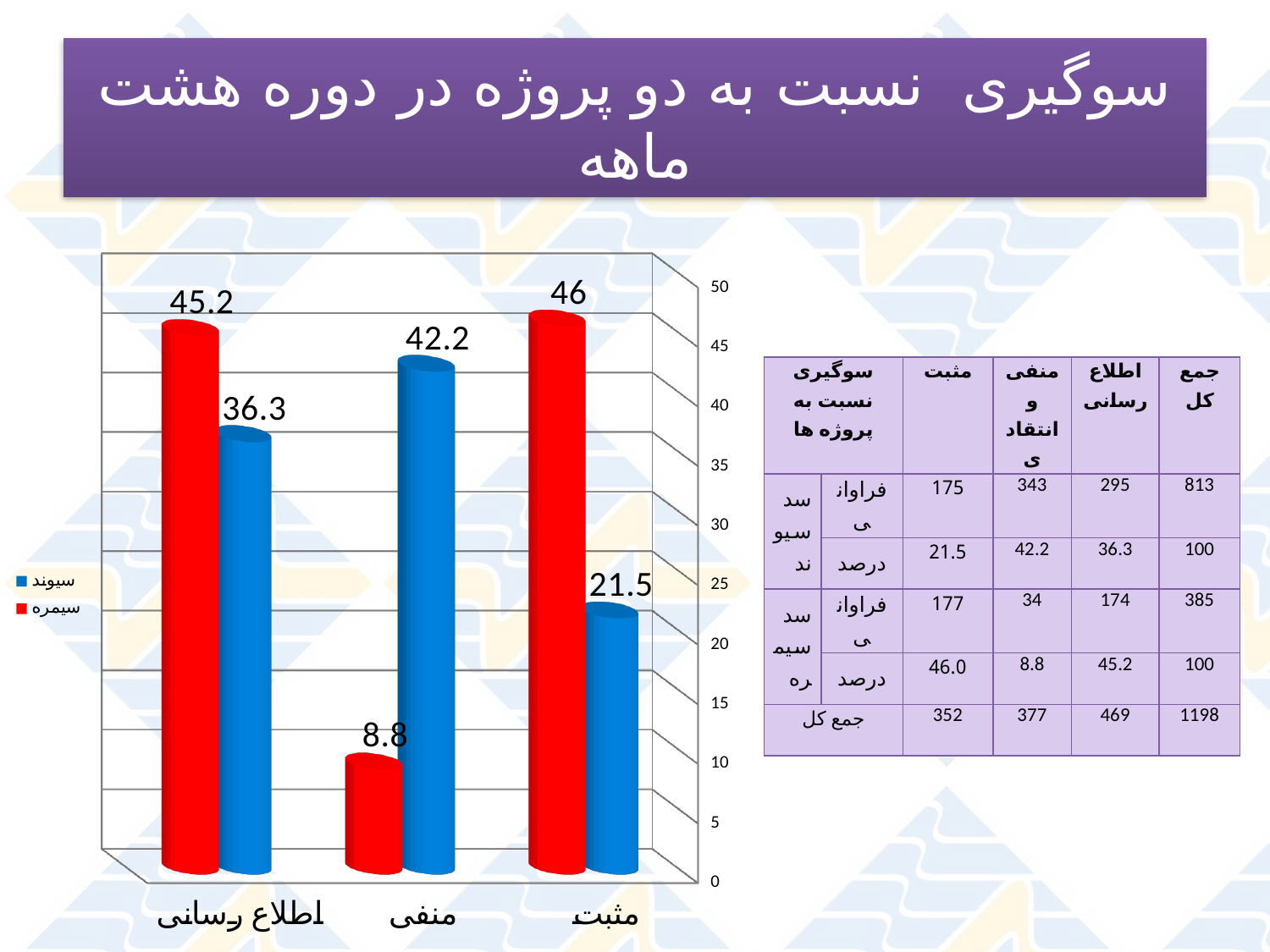
What is the value for سیمره in the مثبت category? 46 Which colour represents the سیوند series in the chart? blue What is the difference between the سیمره and سیوند values in the مثبت category? 24.5 What is the value for سیمره in the اطلاع رسانی category? 45.2 How many categories are shown on the x axis of the chart? 3 How many series does the chart legend list? 2 Which category has the highest value for سیوند? منفی In the اطلاع رسانی category, which series has the larger value, سیوند or سیمره? سیمره What is the value for سیوند in the مثبت category? 21.5 What is the value for سیوند in the منفی category? 42.2 Which category has the lowest value for سیمره? منفی What kind of chart is shown on the slide? bar chart